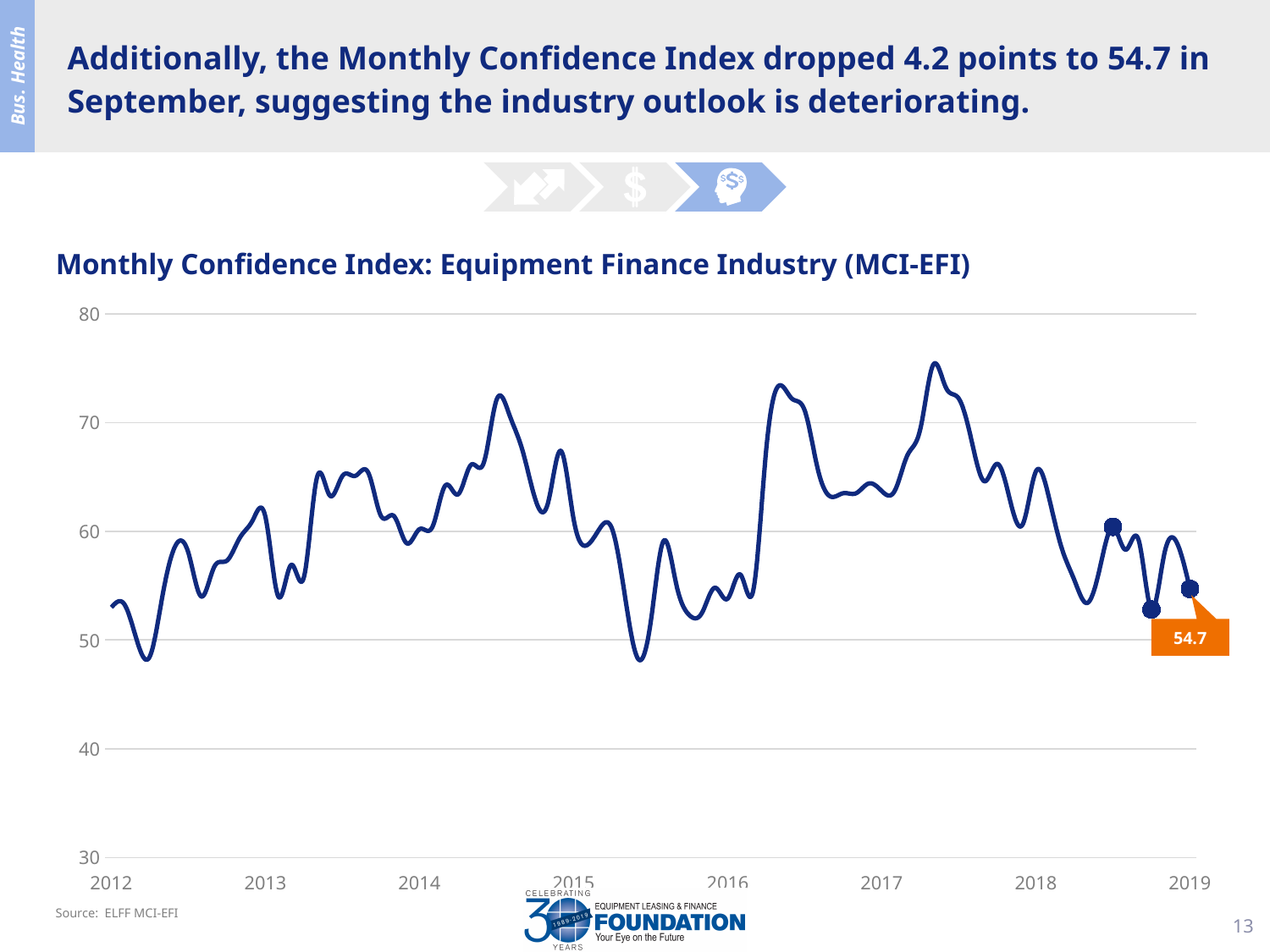
Does the index generally rise or fall between the start of 2018 and the end of the series in 2019? fall What is the title of the chart? Monthly Confidence Index: Equipment Finance Industry (MCI-EFI) What is the source cited for the chart? ELFF MCI-EFI Is the peak value of the index in 2017 greater or less than 70? greater Is the value of the index at the start of 2016 greater or less than 60? less What value is labelled at the final data point of the line? 54.7 What is the highest value shown on the y axis? 80 Is the value of the index at the start of 2012 greater or less than 60? less What kind of chart is shown on the slide? line chart How many year labels are shown on the x axis? 8